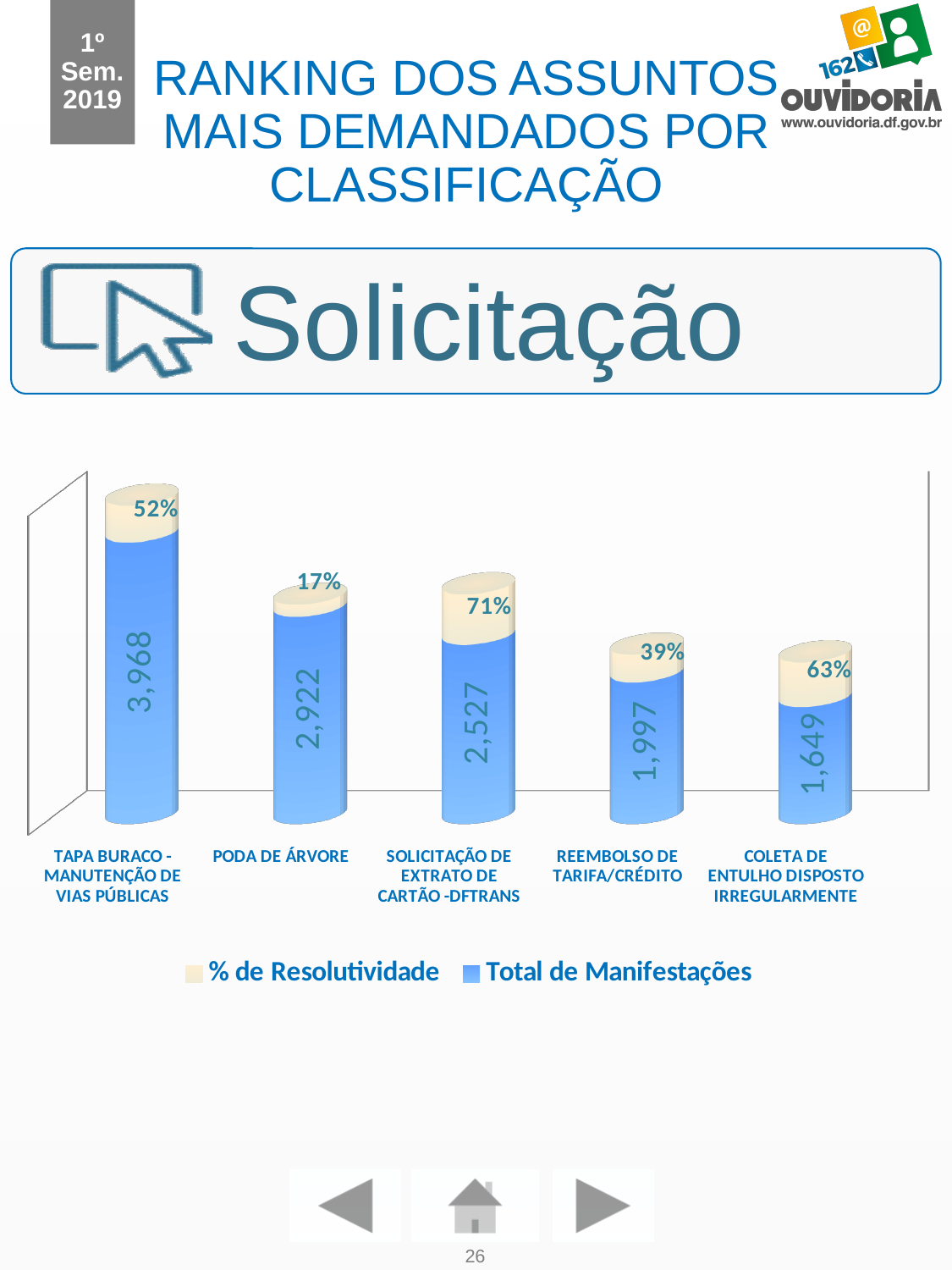
How many series does the legend list? 2 What kind of chart is shown on the slide? Bar chart What is the difference in Total de Manifestações between TAPA BURACO - MANUTENÇÃO DE VIAS PÚBLICAS and PODA DE ÁRVORE? 1,046 What is the Total de Manifestações for TAPA BURACO - MANUTENÇÃO DE VIAS PÚBLICAS? 3,968 Which category has the lowest Total de Manifestações? COLETA DE ENTULHO DISPOSTO IRREGULARMENTE What is the % de Resolutividade for SOLICITAÇÃO DE EXTRATO DE CARTÃO - DFTRANS? 71% What is the % de Resolutividade for PODA DE ÁRVORE? 17% Which has a higher % de Resolutividade: REEMBOLSO DE TARIFA/CRÉDITO or COLETA DE ENTULHO DISPOSTO IRREGULARMENTE? COLETA DE ENTULHO DISPOSTO IRREGULARMENTE Which category has the highest Total de Manifestações? TAPA BURACO - MANUTENÇÃO DE VIAS PÚBLICAS How many categories are shown in the chart? 5 Which category has the lowest % de Resolutividade? PODA DE ÁRVORE What is the Total de Manifestações for REEMBOLSO DE TARIFA/CRÉDITO? 1,997